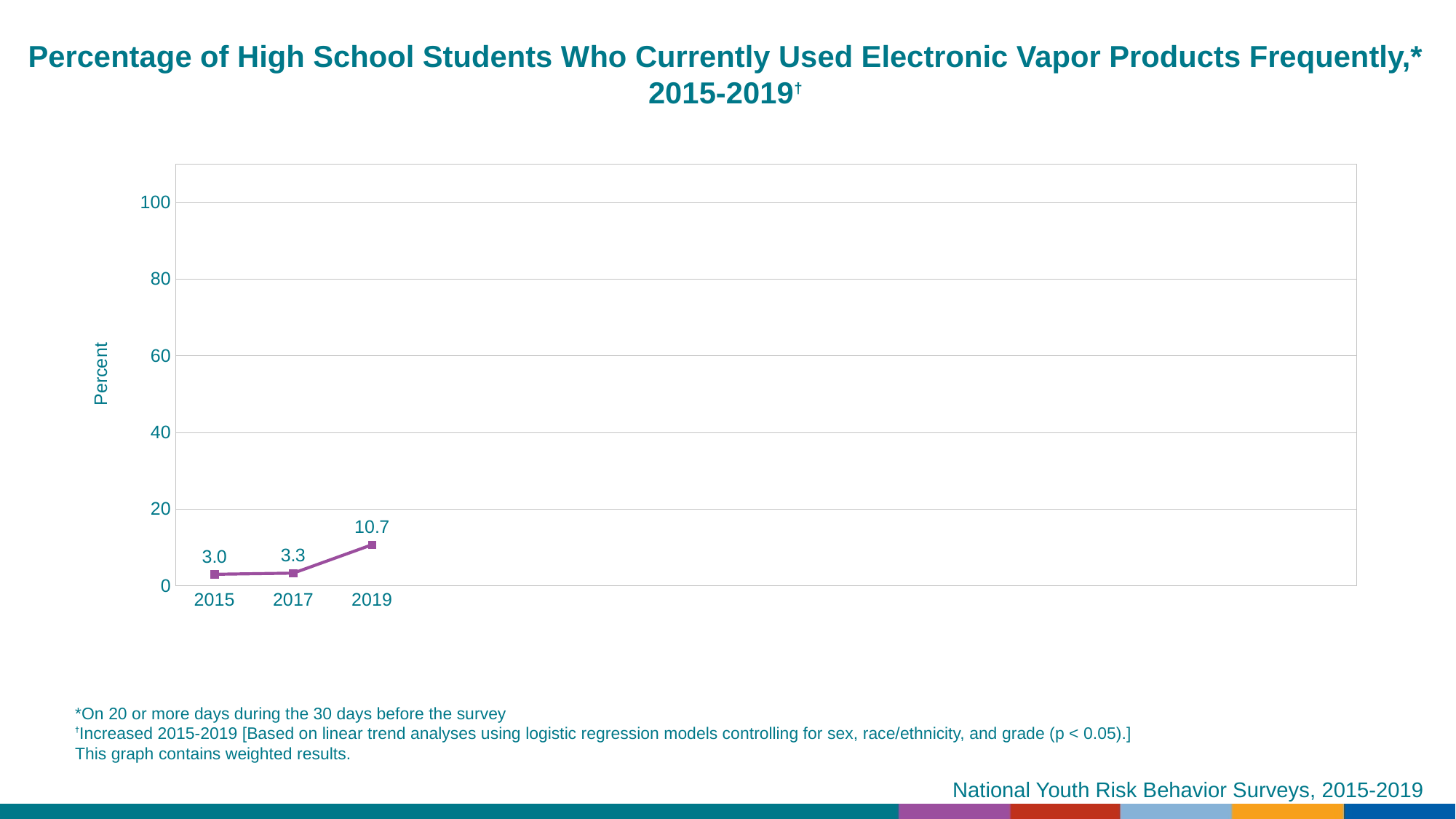
Which year has the lowest percentage of students who currently used electronic vapor products frequently? 2015 Do the values rise or fall from 2015 to 2019? rise What is the difference between the 2019 and 2017 percentages? 7.4 Is the value for 2019 greater or less than 20? less What was the percentage of high school students who currently used electronic vapor products frequently in 2019? 10.7 What kind of chart is shown on the slide? line chart What was the percentage of high school students who currently used electronic vapor products frequently in 2015? 3.0 How many years are plotted on the chart? 3 Which year has a larger value, 2017 or 2019? 2019 What was the percentage of high school students who currently used electronic vapor products frequently in 2017? 3.3 What is the difference between the 2019 and 2015 percentages? 7.7 Which year has the highest percentage of students who currently used electronic vapor products frequently? 2019